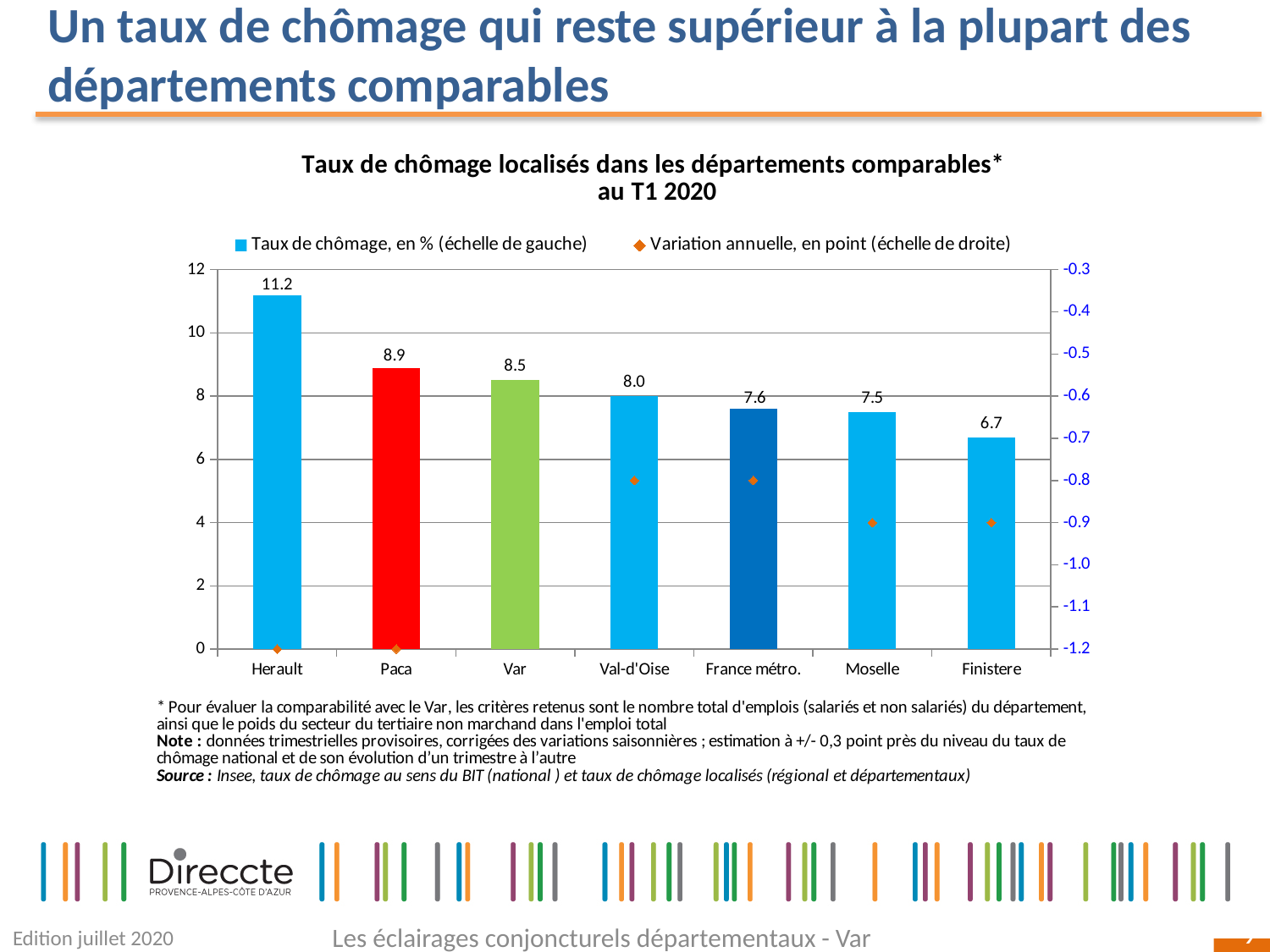
What is the difference between the unemployment rates of Paca and Finistere? 2.2 What is the difference between the unemployment rates of Herault and Var? 2.7 What is the unemployment rate shown for France métro.? 7.6 How many departments or areas are shown on the x axis of the chart? 7 What is the unemployment rate shown for Var? 8.5 Do the unemployment rate bars rise or fall from left to right along the x axis? fall How many series does the chart legend list? 2 Which department or area has the lowest unemployment rate in the chart? Finistere Which department or area has the highest unemployment rate in the chart? Herault What is the unemployment rate (Taux de chômage) shown for Herault? 11.2 Is the annual variation (Variation annuelle) for Herault greater or less than -1.0? less Which has a higher unemployment rate, Val-d'Oise or Moselle? Val-d'Oise